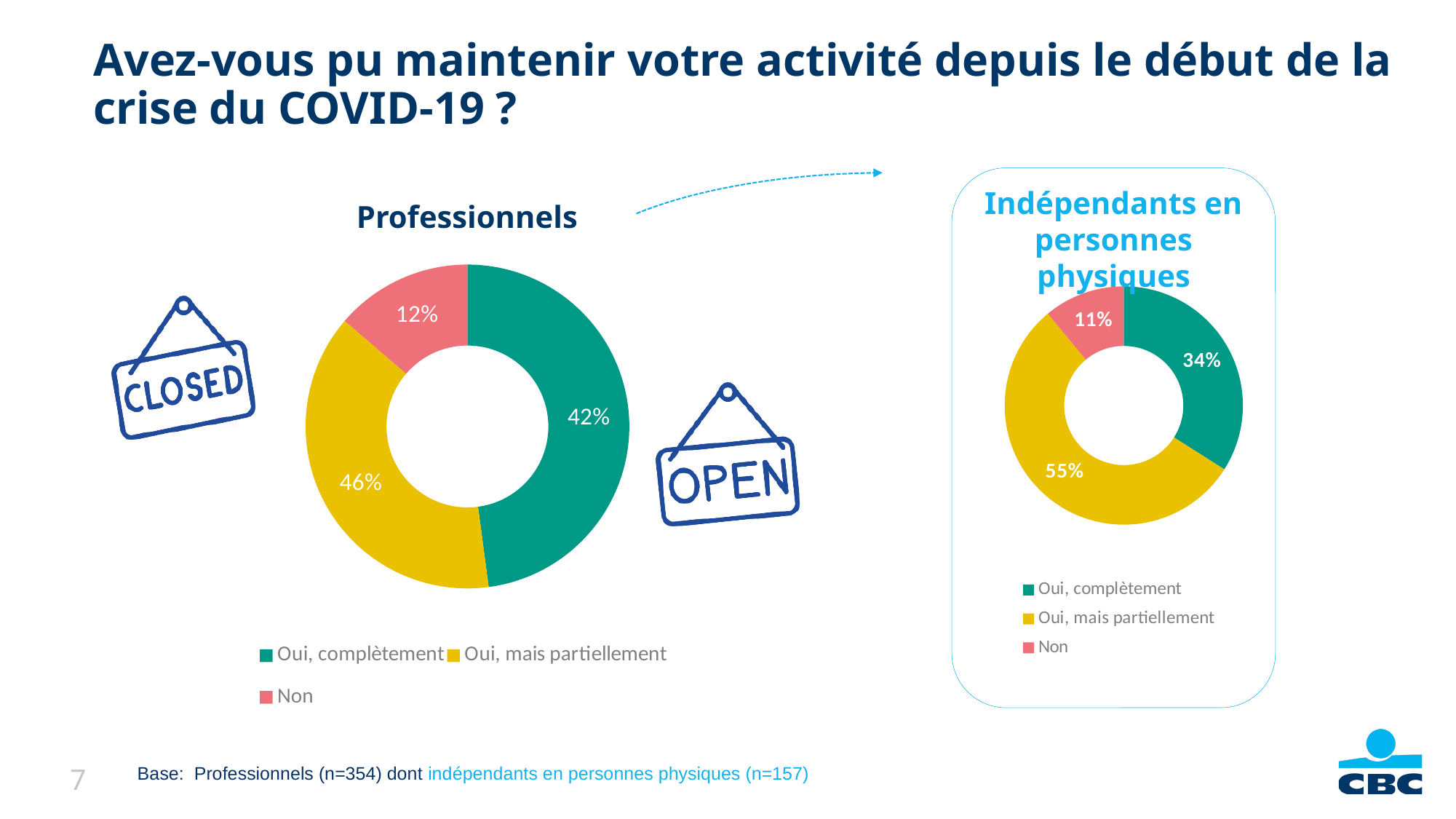
In the 'Professionnels' chart, what is the value for 'Non'? 12% In the 'Indépendants en personnes physiques' chart, what is the value for 'Oui, mais partiellement'? 55% In the 'Indépendants en personnes physiques' chart, which category has the largest share? Oui, mais partiellement In the 'Professionnels' chart, what is the value for 'Oui, complètement'? 42% In the 'Indépendants en personnes physiques' chart, what is the value for 'Non'? 11% In the 'Professionnels' chart, what is the difference between 'Oui, mais partiellement' and 'Oui, complètement'? 4% In the 'Professionnels' chart, what is the value for 'Oui, mais partiellement'? 46% In the 'Professionnels' chart, which category has the smallest share? Non How many categories does the 'Professionnels' chart show? 3 In the 'Indépendants en personnes physiques' chart, what is the difference between 'Oui, mais partiellement' and 'Oui, complètement'? 21% What kind of chart is the 'Professionnels' chart? Doughnut chart In the 'Indépendants en personnes physiques' chart, what is the value for 'Oui, complètement'? 34%